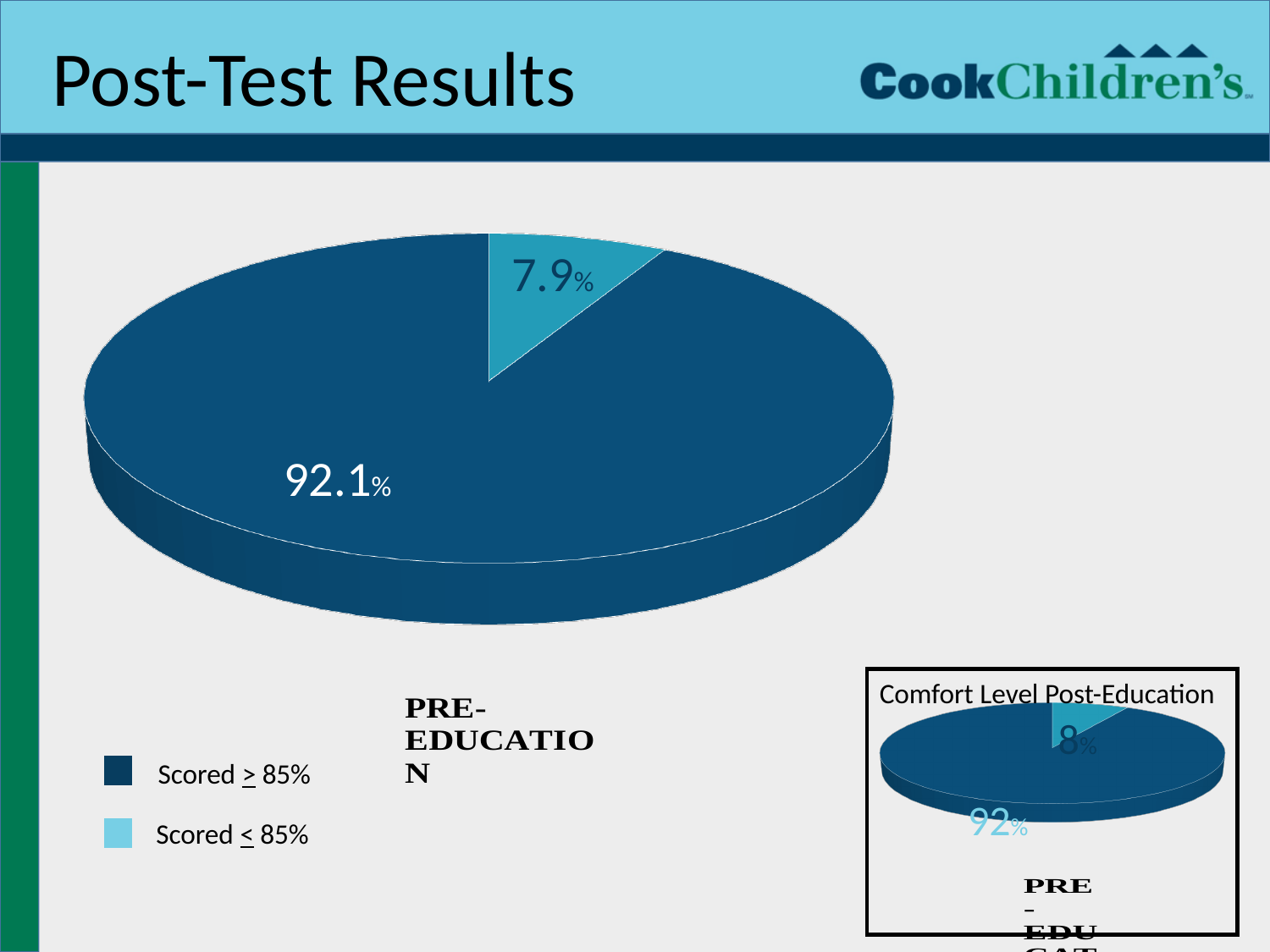
In the small pie chart titled 'Comfort Level Post-Education', what share is shown for the smaller slice? 8% In the small pie chart titled 'Comfort Level Post-Education', what share is shown for the larger slice? 92% In the large pie chart, what share is shown for the 'Scored ≤ 85%' slice? 7.9% In the large pie chart, how many slices are there? 2 In the large pie chart, which slice is the smallest? Scored ≤ 85% In the large pie chart, what share is shown for the 'Scored ≥ 85%' slice? 92.1% In the large pie chart, what is the difference between the two slices' percentages? 84.2% In the large pie chart, which slice is the largest? Scored ≥ 85% What kind of chart is the large chart on the slide? Pie chart In the small pie chart titled 'Comfort Level Post-Education', what is the difference between the two slices' percentages? 84% How many entries does the legend on the slide list? 2 What is the title of the small pie chart in the bottom right of the slide? Comfort Level Post-Education